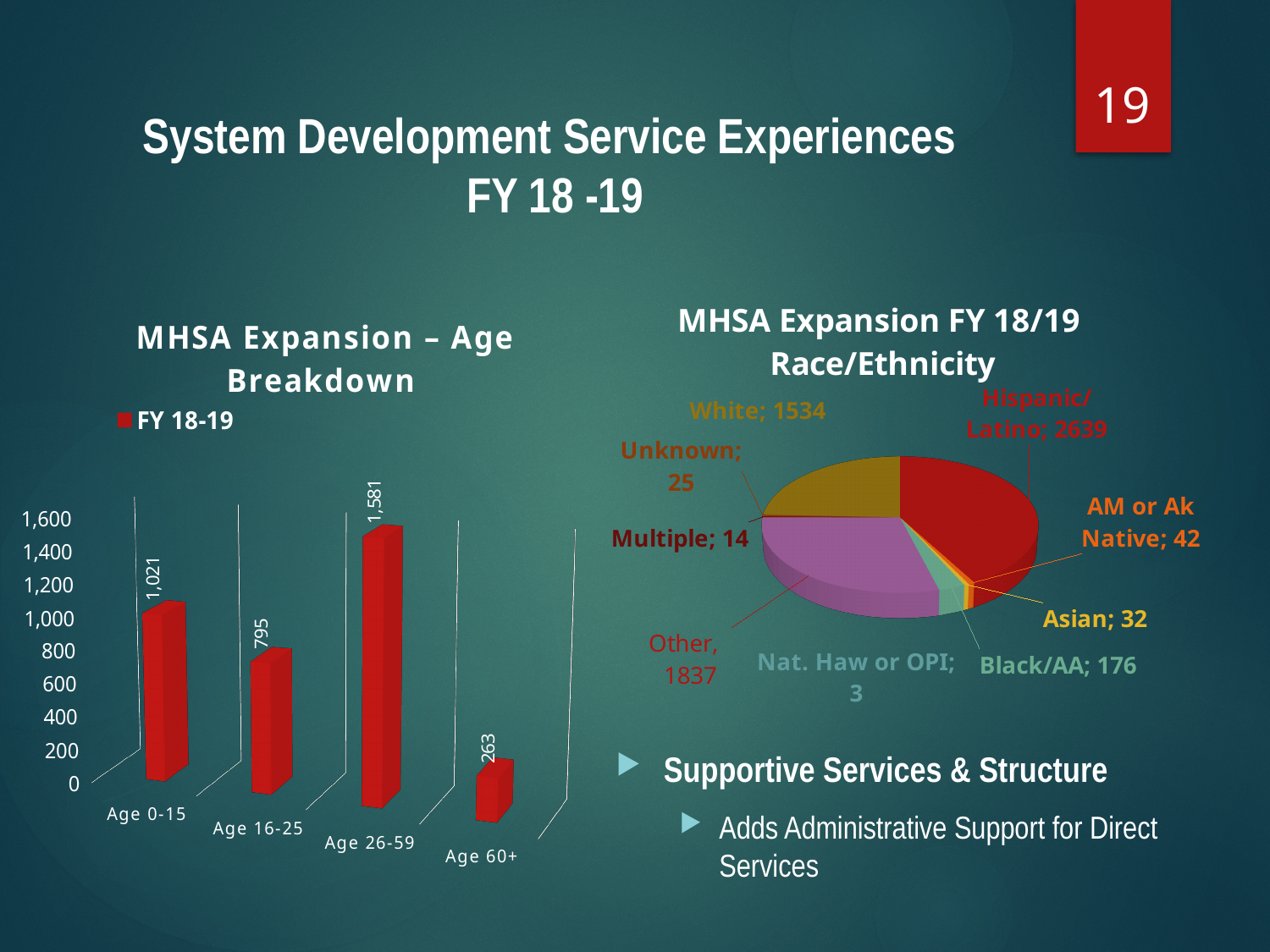
In the MHSA Expansion – Age Breakdown chart, what is the value for Age 60+? 263 In the MHSA Expansion – Age Breakdown chart, which age group has the highest value? Age 26-59 In the MHSA Expansion – Age Breakdown chart, what series does the legend list? FY 18-19 In the MHSA Expansion – Age Breakdown chart, how many age groups are shown? 4 In the MHSA Expansion FY 18/19 Race/Ethnicity chart, what is the value for Black/AA? 176 In the MHSA Expansion – Age Breakdown chart, what is the value for Age 0-15? 1,021 In the MHSA Expansion FY 18/19 Race/Ethnicity chart, which is larger, Other or White? Other In the MHSA Expansion FY 18/19 Race/Ethnicity chart, what is the difference between Hispanic/Latino and Other? 802 In the MHSA Expansion – Age Breakdown chart, which age group has the lowest value? Age 60+ In the MHSA Expansion FY 18/19 Race/Ethnicity chart, which category has the largest slice? Hispanic/Latino In the MHSA Expansion – Age Breakdown chart, what is the difference between the values for Age 26-59 and Age 0-15? 560 What kind of chart is the MHSA Expansion – Age Breakdown chart? Bar chart